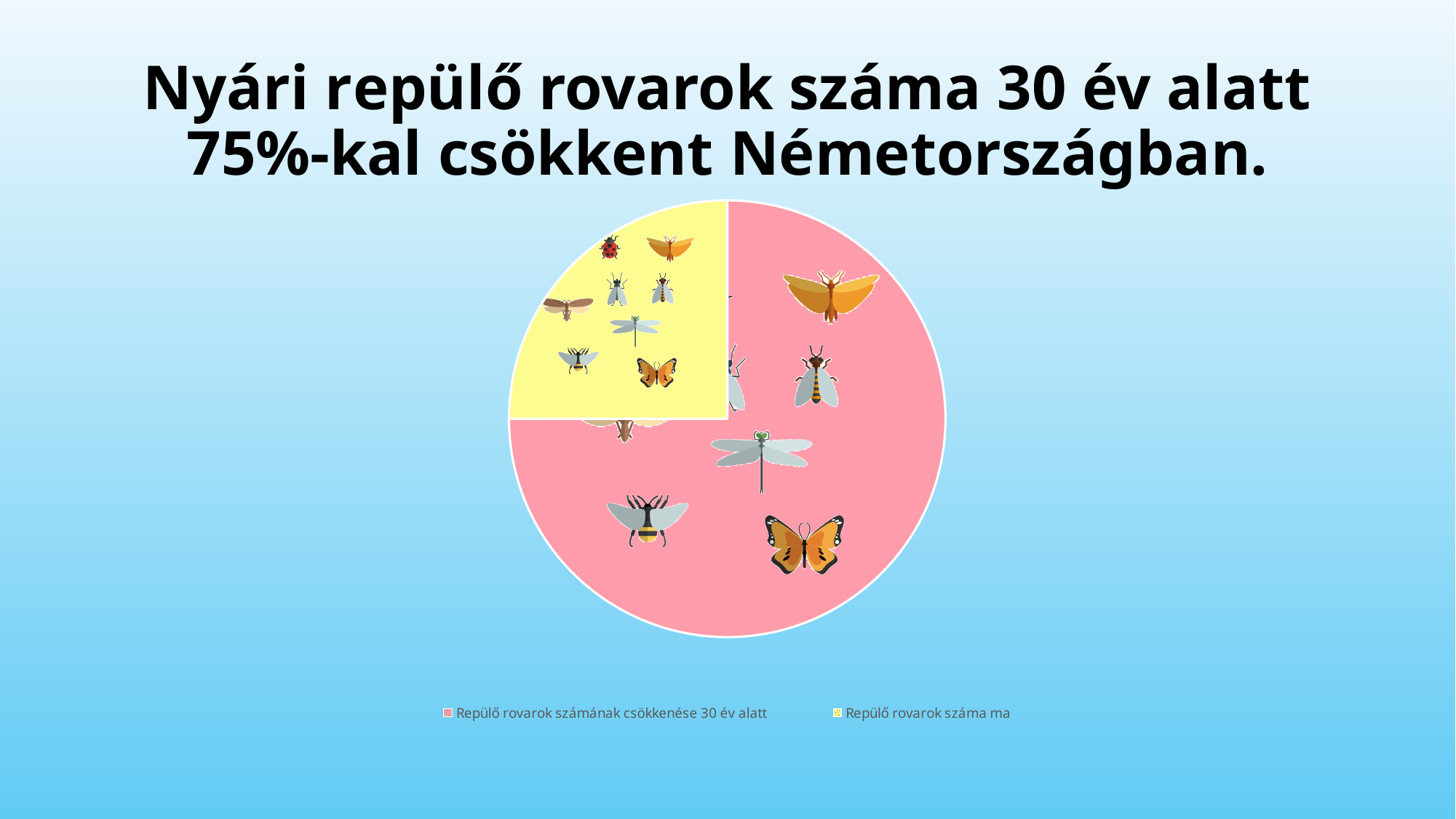
Which slice of the pie chart is the smallest? Repülő rovarok száma ma Which slice of the pie chart is the largest? Repülő rovarok számának csökkenése 30 év alatt How many slices does the pie chart have? 2 Which is larger in the pie chart: 'Repülő rovarok számának csökkenése 30 év alatt' or 'Repülő rovarok száma ma'? Repülő rovarok számának csökkenése 30 év alatt How many entries does the legend of the pie chart list? 2 What share of the pie does the slice 'Repülő rovarok számának csökkenése 30 év alatt' represent, according to the slide? 75% What kind of chart is shown on the slide? pie chart What colour is the slice for 'Repülő rovarok száma ma' in the pie chart? yellow What is the title of the slide containing the pie chart? Nyári repülő rovarok száma 30 év alatt 75%-kal csökkent Németországban.